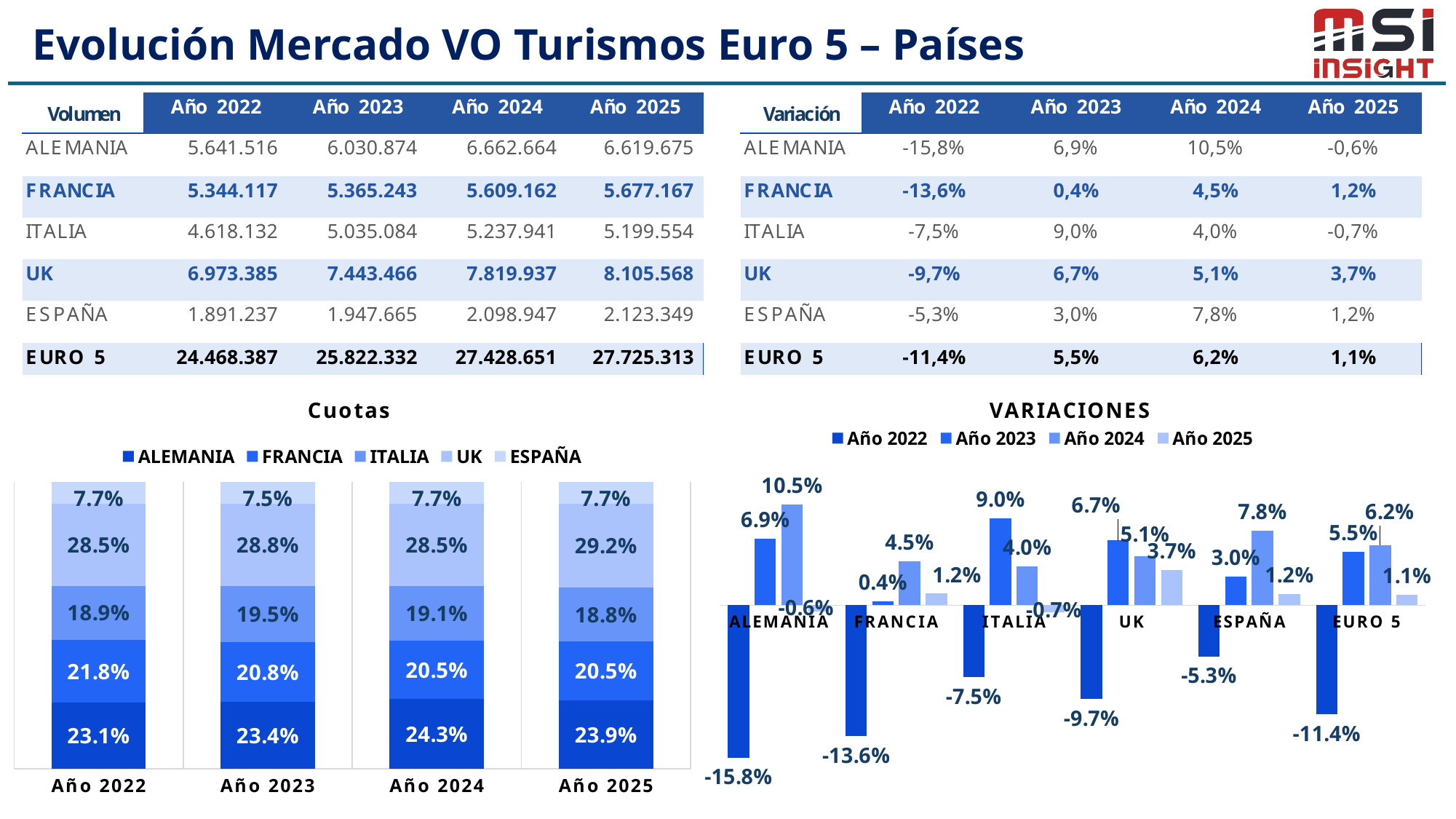
In the "VARIACIONES" chart, what is the value for EURO 5 in Año 2025? 1.1% In the "Cuotas" chart, what is the share for ALEMANIA in Año 2024? 24.3% In the "Cuotas" chart, which country has the largest share in Año 2022? UK In the "Cuotas" chart, what is the share for UK in Año 2025? 29.2% In the "Cuotas" chart, what is the difference between the ALEMANIA and FRANCIA shares in Año 2024? 3.8 percentage points In the "Cuotas" chart, how many series does the legend list? 5 In the "VARIACIONES" chart, which is larger for Año 2023: UK or ESPAÑA? UK In the "VARIACIONES" chart, which category has the lowest value for Año 2022? ALEMANIA What kind of chart is the "Cuotas" chart on the left? Stacked bar chart In the "VARIACIONES" chart, how many series does the legend list? 4 In the "VARIACIONES" chart, how many categories are shown on the x axis? 6 In the "VARIACIONES" chart, what is the value for ALEMANIA in Año 2024? 10.5%